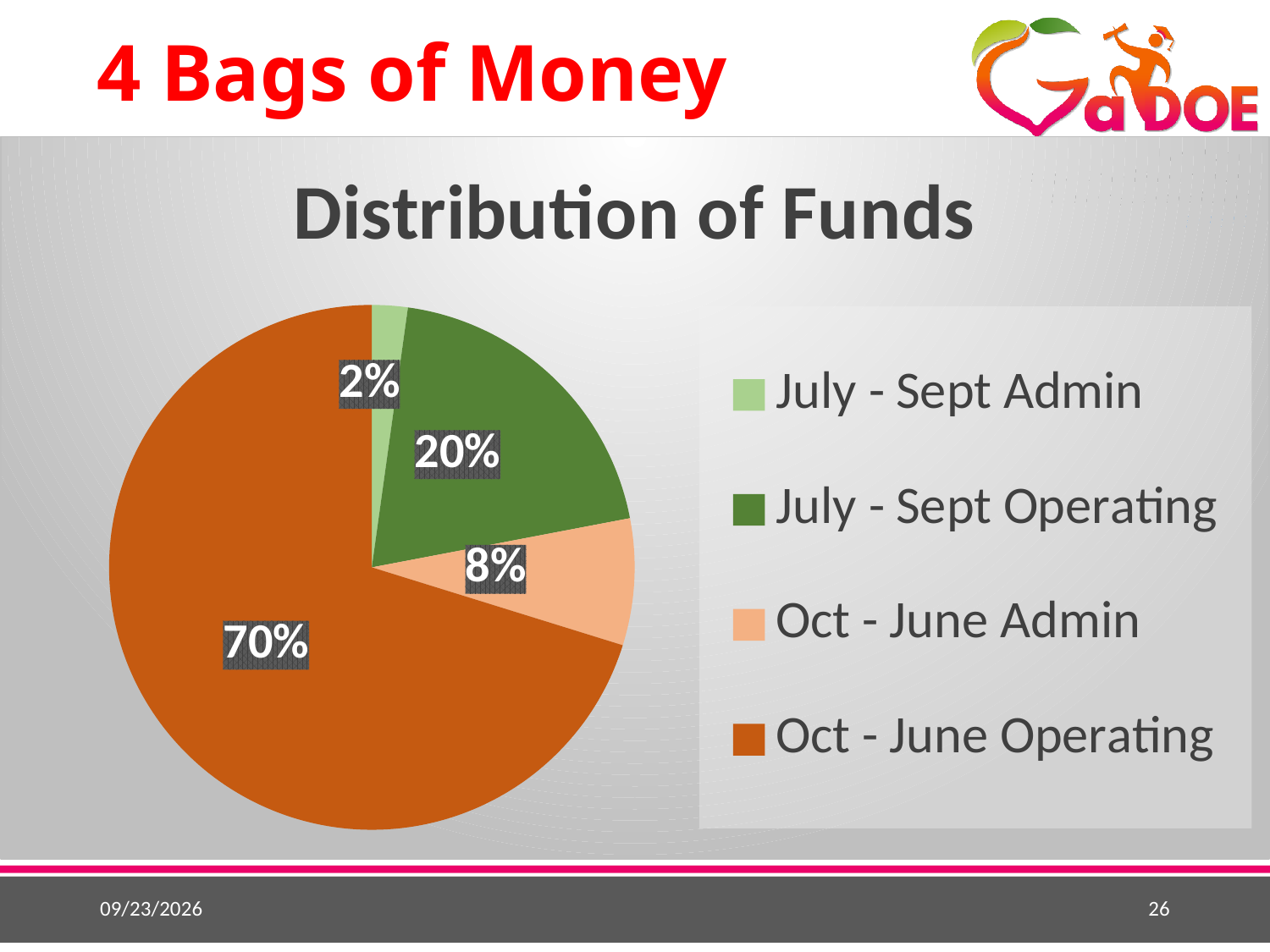
What colour is the slice for Oct - June Operating? orange What share of funds goes to July - Sept Operating? 20% What is the title of the chart? Distribution of Funds Which is larger, the Oct - June Admin share or the July - Sept Admin share? Oct - June Admin What is the difference between the Oct - June Operating share and the July - Sept Operating share? 50 percentage points How many categories does the pie chart show? 4 What type of chart is shown on the slide? pie chart What share of funds goes to July - Sept Admin? 2% Which category has the smallest share of the pie? July - Sept Admin Which category has the largest share of the pie? Oct - June Operating What share of funds goes to Oct - June Operating? 70% What share of funds goes to Oct - June Admin? 8%